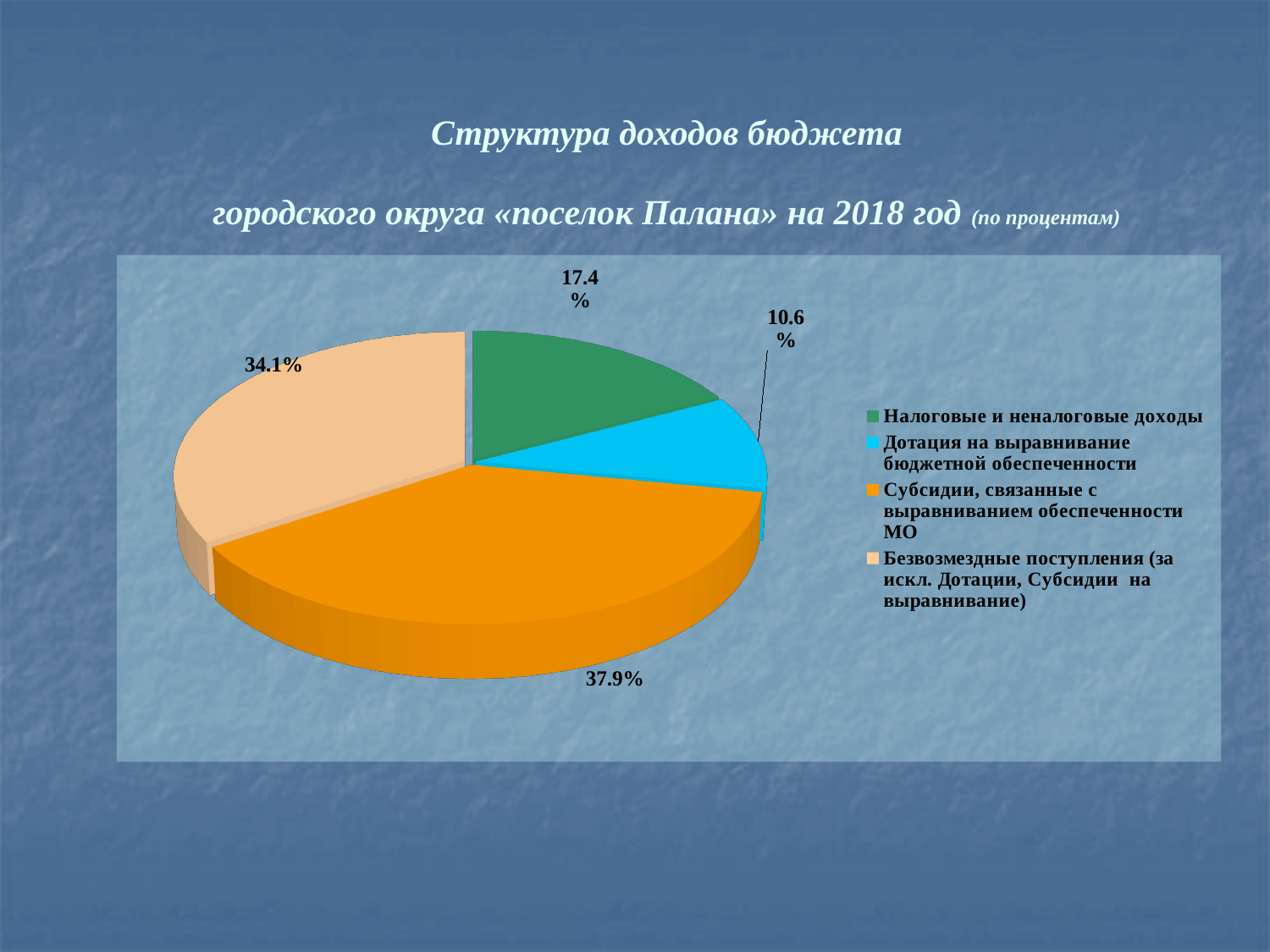
What is the difference in percentage points between the «Субсидии» slice and the «Безвозмездные поступления» slice? 3.8 What share of the pie is labelled for «Безвозмездные поступления (за искл. Дотации, Субсидии на выравнивание)»? 34.1% What share of the pie is labelled for «Налоговые и неналоговые доходы»? 17.4% What share of the pie is labelled for «Дотация на выравнивание бюджетной обеспеченности»? 10.6% Which is larger: the «Налоговые и неналоговые доходы» slice or the «Дотация на выравнивание бюджетной обеспеченности» slice? Налоговые и неналоговые доходы What kind of chart is shown on the slide? Pie chart How many categories does the pie chart contain? 4 What share of the pie is labelled for «Субсидии, связанные с выравниванием обеспеченности МО»? 37.9% What colour is the slice for «Субсидии, связанные с выравниванием обеспеченности МО»? Orange Which category has the smallest slice of the pie? Дотация на выравнивание бюджетной обеспеченности What is the difference in percentage points between the «Налоговые и неналоговые доходы» slice and the «Дотация» slice? 6.8 Which category has the largest slice of the pie? Субсидии, связанные с выравниванием обеспеченности МО